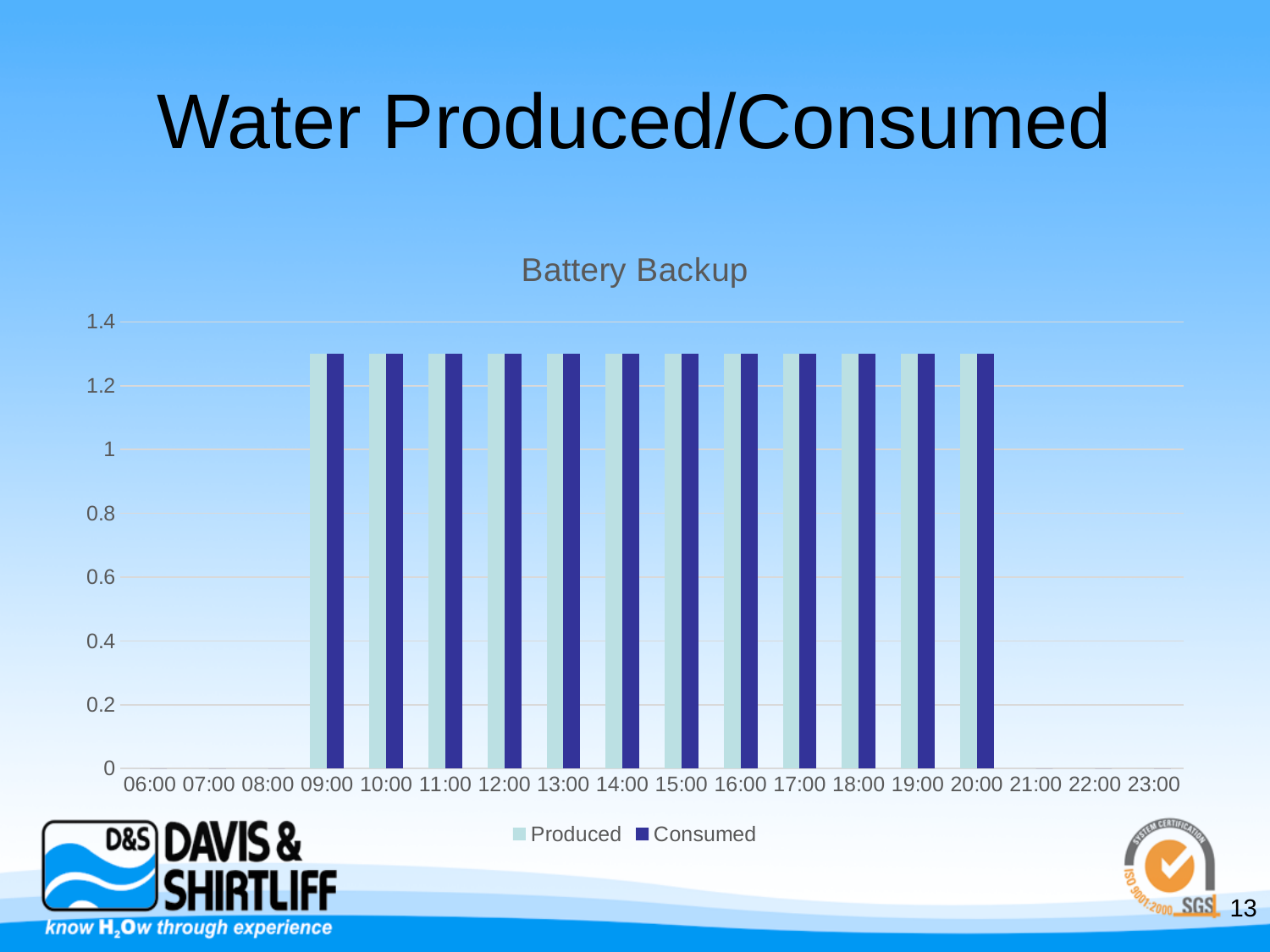
How many time categories are shown on the x axis? 18 Is the Produced value at 22:00 greater or less than 0.2? less What is the first time on the x axis at which bars appear? 09:00 What are the two series named in the legend? Produced and Consumed What is the title of the chart? Battery Backup Is the Consumed value at 15:00 greater or less than 1.2? greater Is the Produced value at 12:00 greater or less than 1? greater Do the Consumed values rise, fall, or stay flat from 09:00 to 20:00? stay flat What kind of chart is shown on the slide? bar chart How many series does the legend list? 2